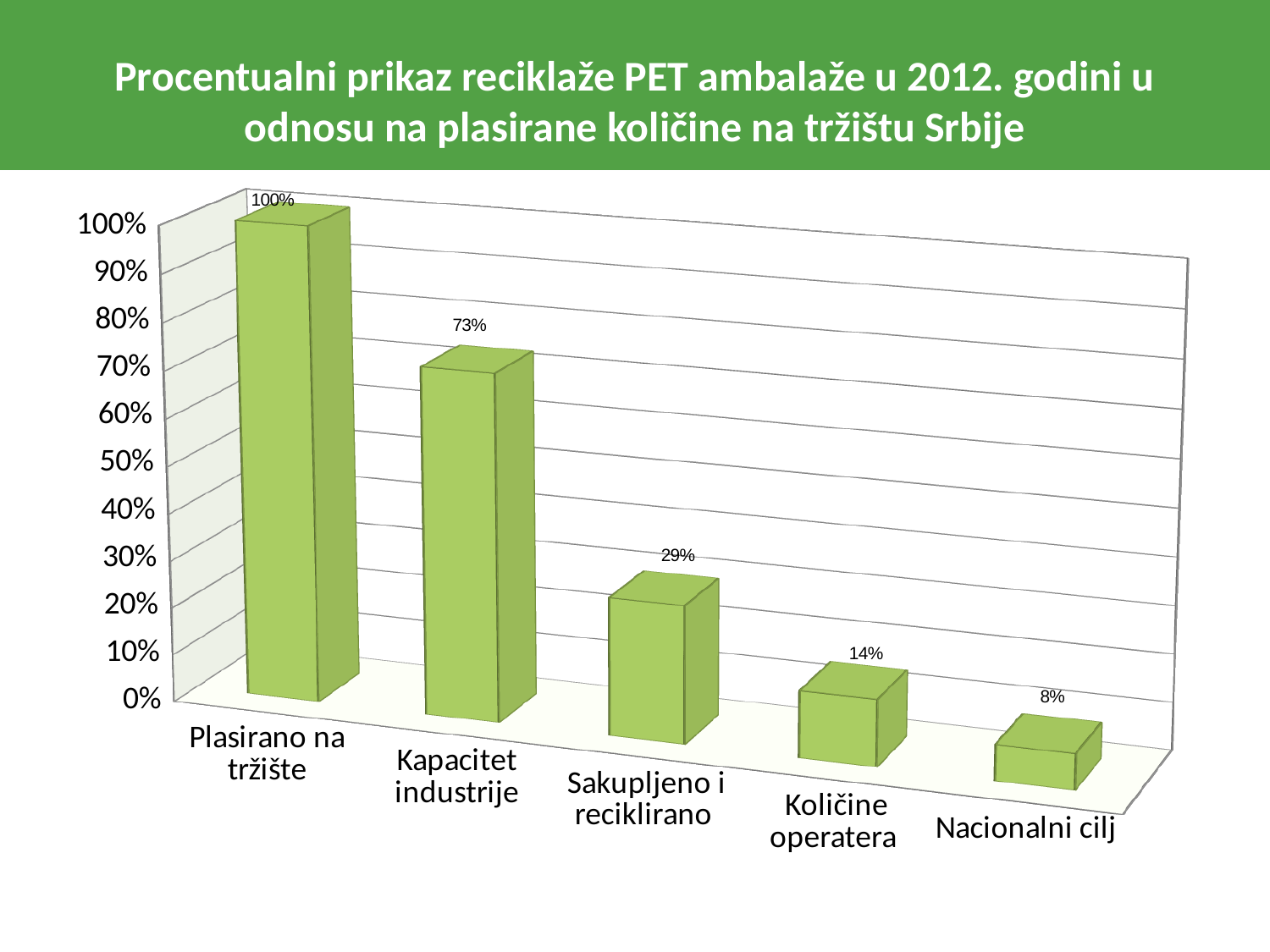
What kind of chart is shown on the slide? Bar chart What is the value for Plasirano na tržište? 100% Do the values rise or fall from left to right along the x axis? Fall Which category has the lowest value? Nacionalni cilj How many categories are shown in the chart? 5 What is the value for Kapacitet industrije? 73% What is the value for Količine operatera? 14% What is the difference between the values for Kapacitet industrije and Sakupljeno i reciklirano? 44% What is the value for Nacionalni cilj? 8% Which is larger, the value for Količine operatera or the value for Nacionalni cilj? Količine operatera Which category has the highest value? Plasirano na tržište What is the value for Sakupljeno i reciklirano? 29%